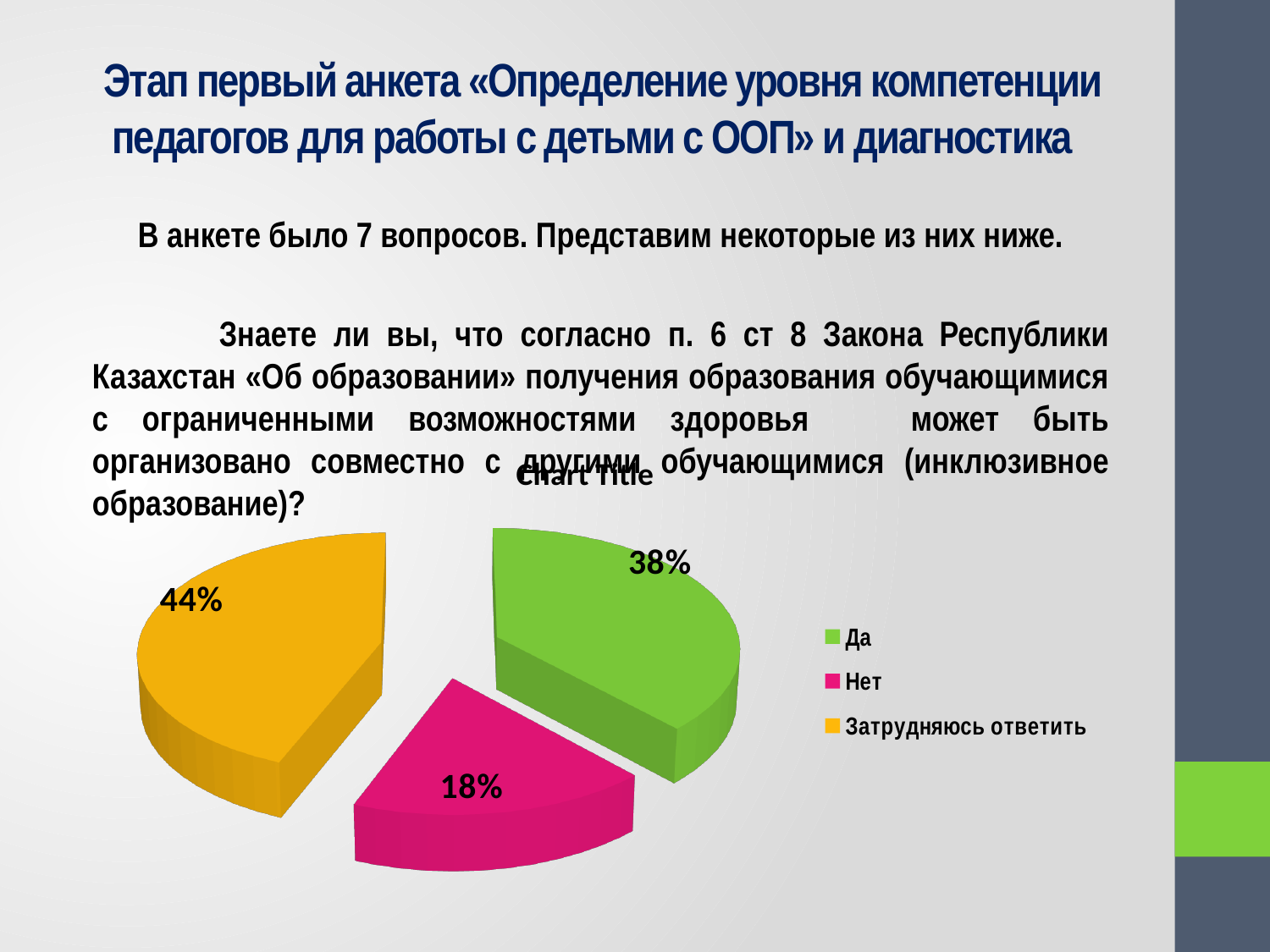
How many entries does the legend list? 3 What share of the pie does the "Нет" slice represent? 18% Which is larger, the "Да" slice or the "Нет" slice? Да What colour is the "Нет" slice in the pie chart? pink What share of the pie does the "Да" slice represent? 38% What is the difference in percentage points between the "Затрудняюсь ответить" slice and the "Да" slice? 6 How many slices does the pie chart have? 3 What is the difference in percentage points between the "Да" slice and the "Нет" slice? 20 Which category has the largest slice of the pie? Затрудняюсь ответить Which category has the smallest slice of the pie? Нет What kind of chart is shown on the slide? pie chart What share of the pie does the "Затрудняюсь ответить" slice represent? 44%